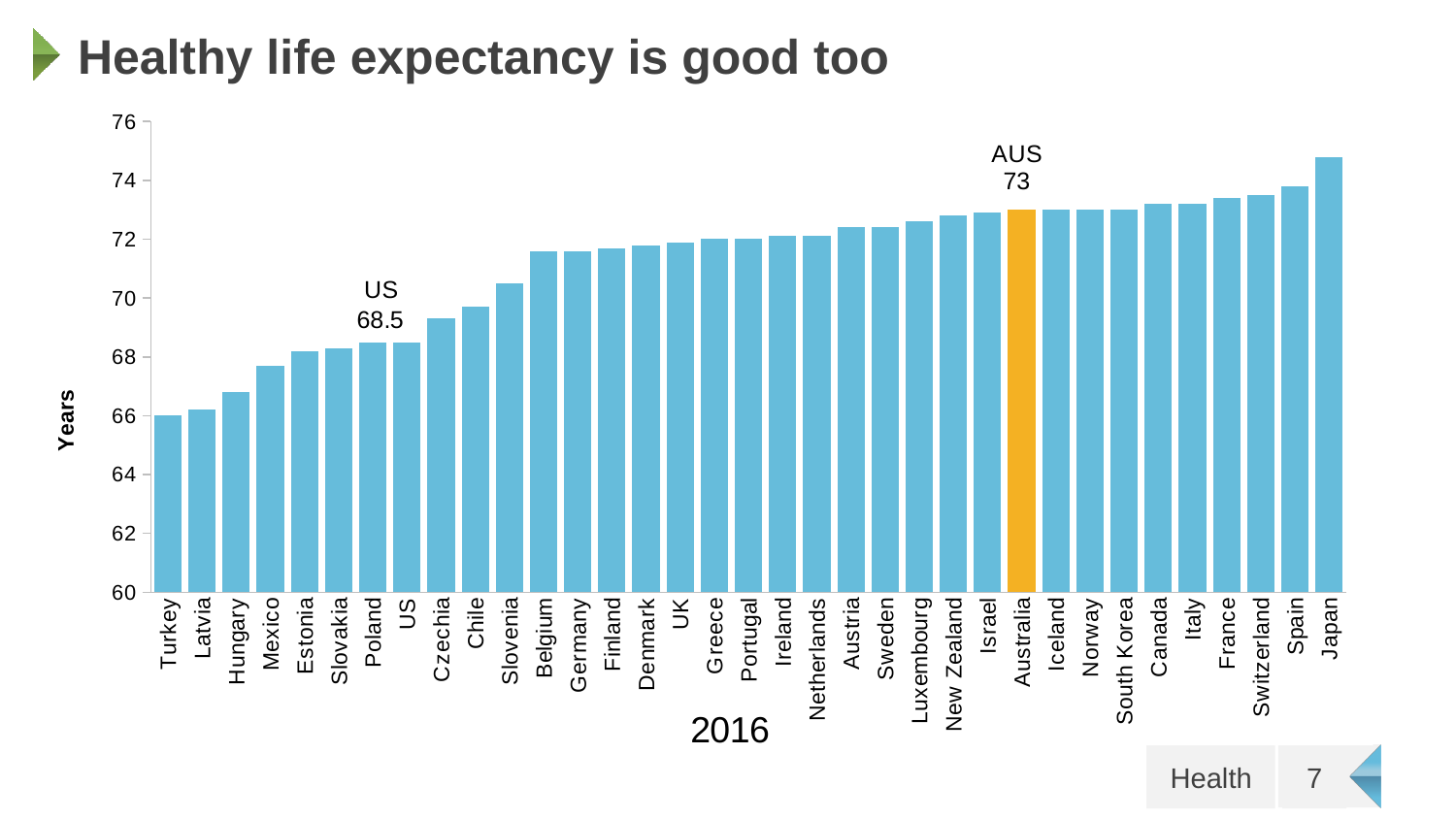
Is the value for Japan greater or less than 74? greater Which country has the highest healthy life expectancy in the chart? Japan What type of chart is shown on the slide? Bar chart What is the difference between the labelled values for Australia and the US? 4.5 Is the value for Slovenia greater or less than 70? greater Is the value for Turkey greater or less than 68? less Which country has the lowest healthy life expectancy in the chart? Turkey What is the healthy life expectancy value shown for the US? 68.5 Do the values rise or fall moving from left to right along the x axis? Rise What is the healthy life expectancy value shown for Australia? 73 Which has a higher healthy life expectancy, Australia or the US? Australia How many countries are shown in the chart? 35